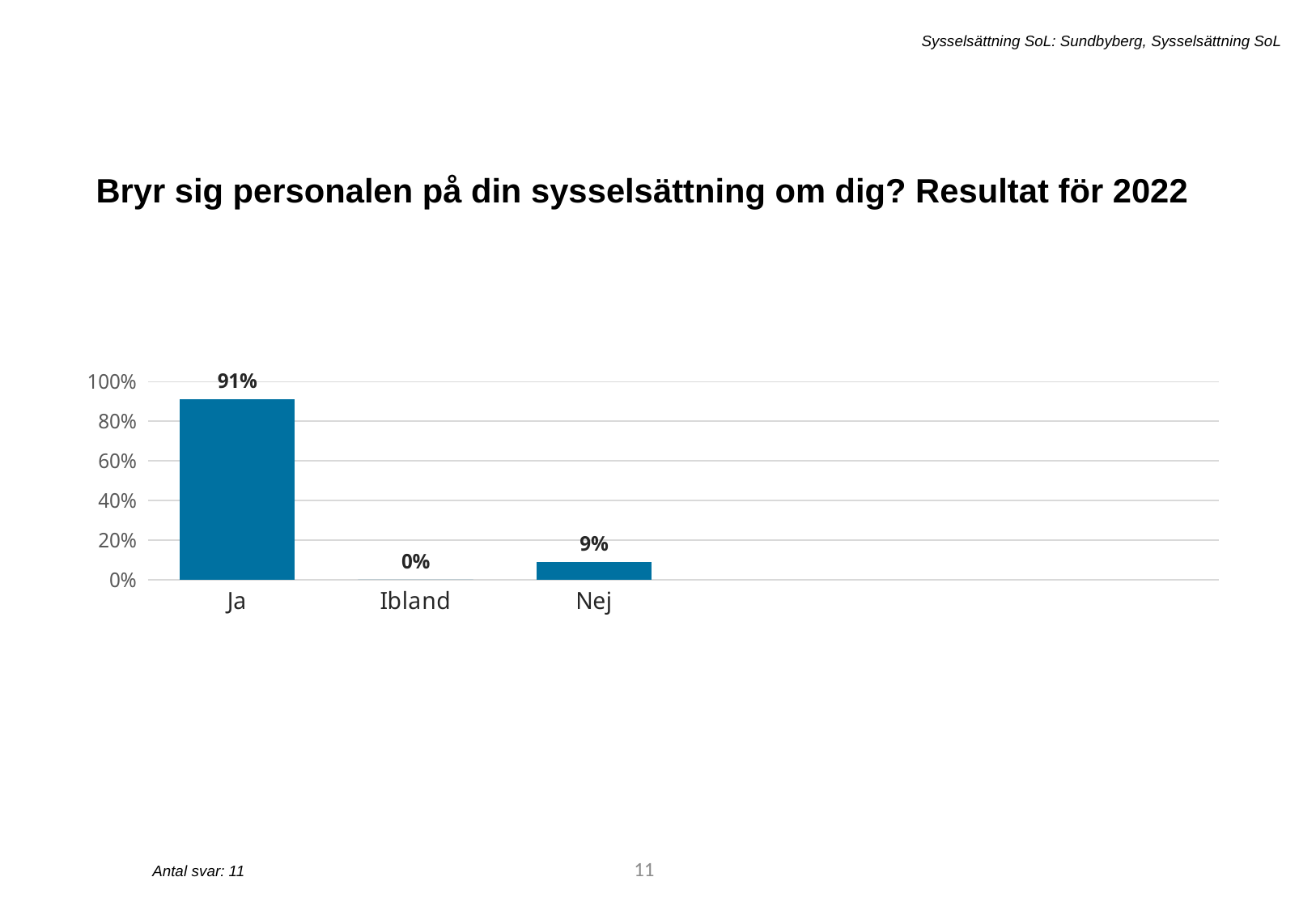
What kind of chart is shown on the slide? bar chart What is the value for Ja? 91% Is the value for Nej greater or less than 20%? less What is the difference between the values for Ja and Nej? 82% Which is larger, the value for Nej or the value for Ibland? Nej Which category has the lowest value? Ibland What is the title of the chart on the slide? Bryr sig personalen på din sysselsättning om dig? Resultat för 2022 What is the value for Nej? 9% How many categories are shown on the x axis? 3 What is the value for Ibland? 0% Is the value for Ja greater or less than 80%? greater Which category has the highest value? Ja